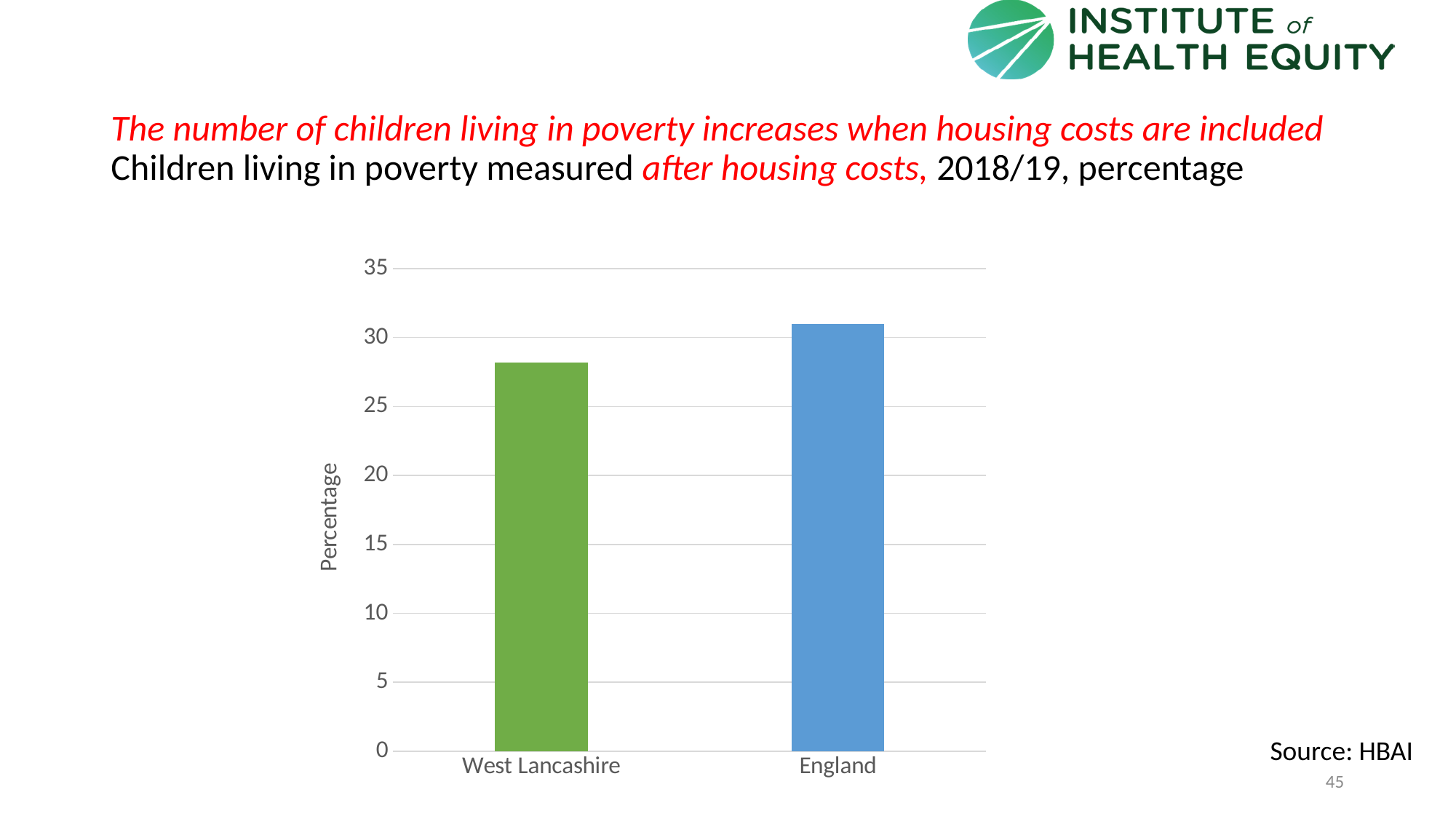
What is the source cited for the chart? HBAI How many categories are plotted on the x axis? 2 Is the value for West Lancashire greater or less than 30? less Which category has the highest value? England What is the label on the vertical axis? Percentage What kind of chart is shown on the slide? bar chart Is the value for West Lancashire greater or less than 25? greater Which category has the lowest value? West Lancashire Which is larger, the value for West Lancashire or the value for England? England Is the value for England greater or less than 35? less